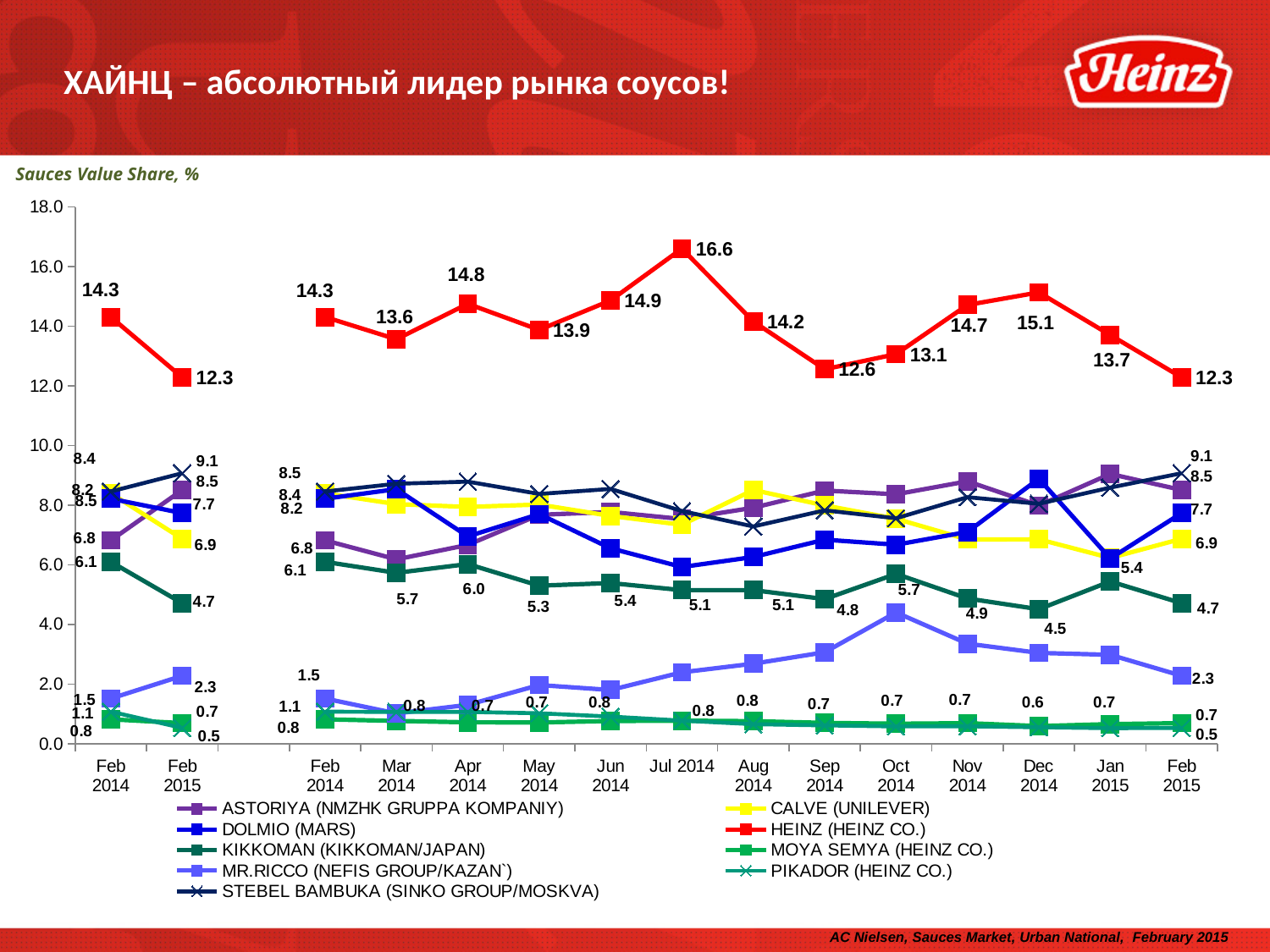
What is the value for HEINZ (HEINZ CO.) in Jul 2014? 16.6 Which series is plotted in red? HEINZ (HEINZ CO.) Is the value for HEINZ (HEINZ CO.) in Jun 2014 greater or less than 14.0? greater What is the difference between the HEINZ (HEINZ CO.) values in Jul 2014 and Sep 2014? 4.0 What is the lowest monthly value shown for HEINZ (HEINZ CO.) between Feb 2014 and Feb 2015? 12.3 How many series does the legend list? 9 What is the title of the chart? Sauces Value Share, % What is the value for KIKKOMAN (KIKKOMAN/JAPAN) in Dec 2014? 4.5 What type of chart is shown on the slide? line chart In which month does HEINZ (HEINZ CO.) reach its highest value? Jul 2014 What is the value for HEINZ (HEINZ CO.) in Dec 2014? 15.1 Which is larger for HEINZ (HEINZ CO.): the value in Apr 2014 or in Mar 2014? Apr 2014